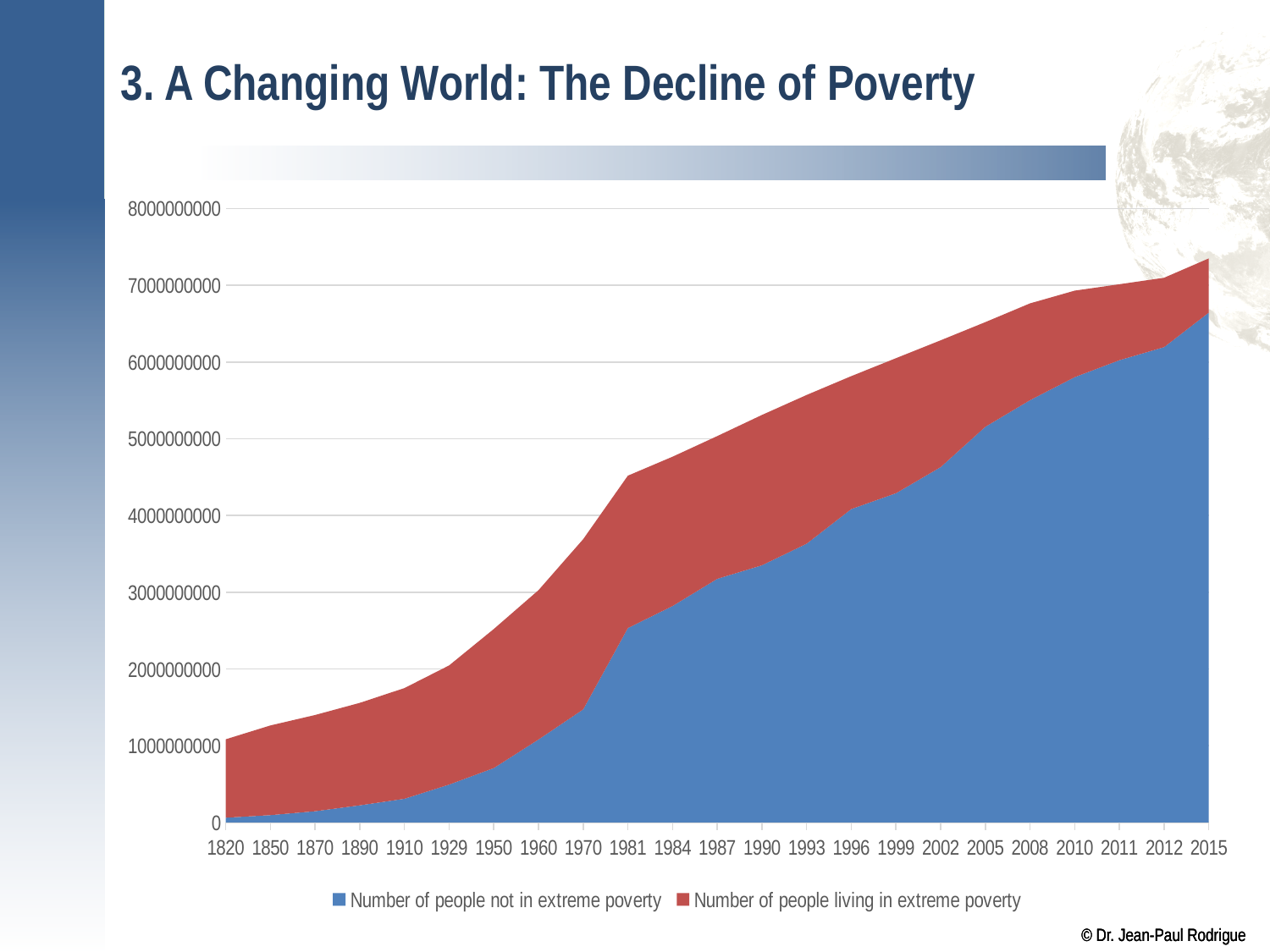
How many series does the legend list? 2 Is the total number of people in 1981 greater or less than 4000000000? greater How many years are labelled along the x axis? 23 Which year has the highest total number of people (both series combined)? 2015 Which colour represents the number of people living in extreme poverty? Red What kind of chart is shown on the slide? Stacked area chart Which year has the lowest total number of people (both series combined)? 1820 Is the number of people not in extreme poverty in 1950 greater or less than 1000000000? less Is the number of people not in extreme poverty in 2015 greater or less than 6000000000? greater Does the number of people not in extreme poverty rise or fall from 1820 to 2015? Rise In 1820, which series is larger: the number of people not in extreme poverty or the number of people living in extreme poverty? Number of people living in extreme poverty